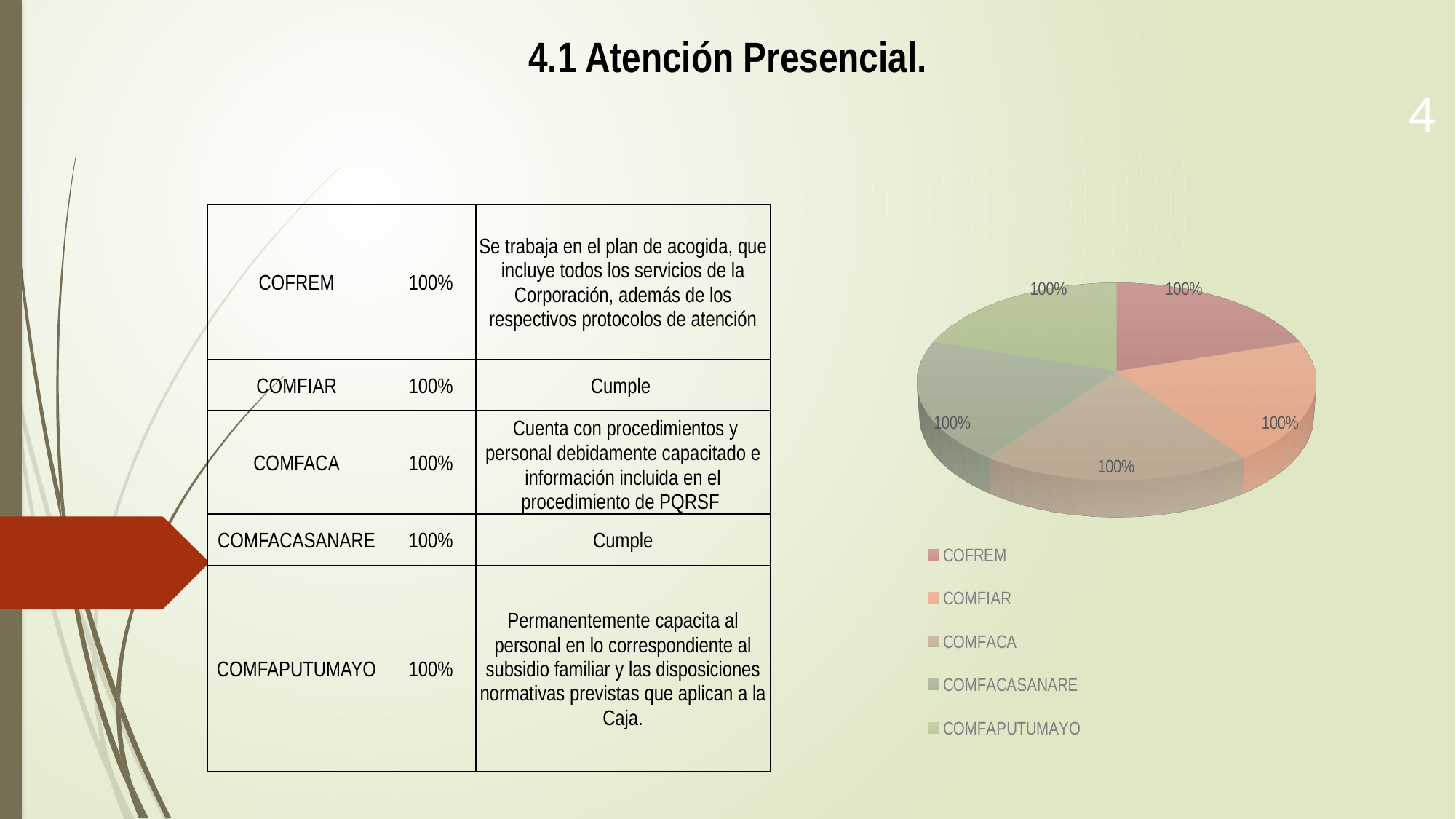
What is the difference between the labelled values for COFREM and COMFAPUTUMAYO in the pie chart? 0% What value is labelled on the COMFACASANARE slice of the pie chart? 100% What value is labelled on the COMFAPUTUMAYO slice of the pie chart? 100% Which entry is listed first in the legend of the pie chart? COFREM What value is labelled on the COMFIAR slice of the pie chart? 100% How many slices does the pie chart have? 5 How many entries does the legend of the pie chart list? 5 What value is labelled on the COMFACA slice of the pie chart? 100% What value is labelled on the COFREM slice of the pie chart? 100% What kind of chart is shown on the slide? pie chart Which entry is listed last in the legend of the pie chart? COMFAPUTUMAYO